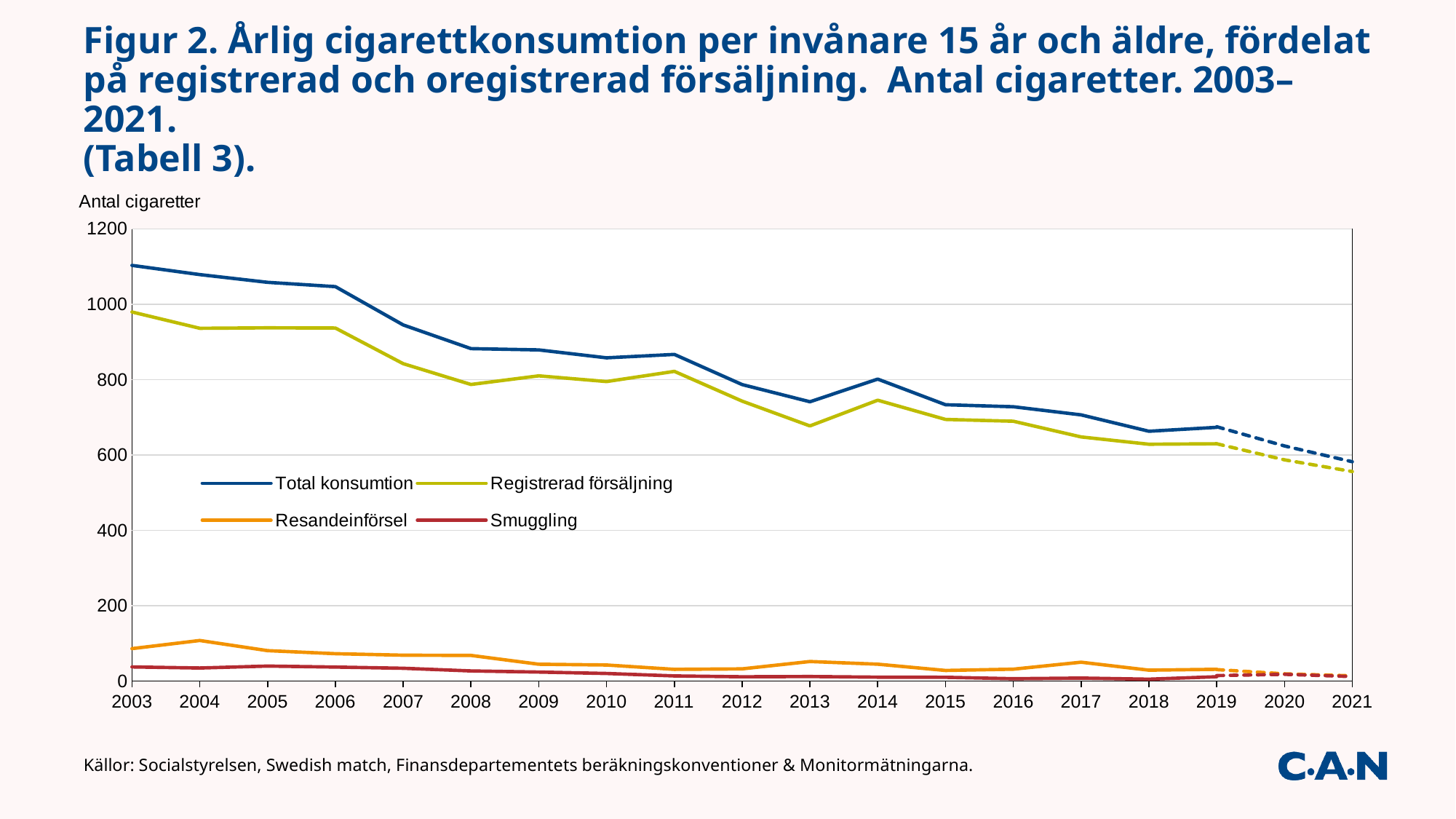
What is the label on the vertical axis of the chart? Antal cigaretter In which year is Resandeinförsel highest? 2004 In which year is Total konsumtion lowest? 2021 Is the value for Resandeinförsel in 2004 greater or less than 200? less Does the Total konsumtion line rise or fall from 2003 to 2021? fall Is the value for Registrerad försäljning in 2008 greater or less than 800? less What kind of chart is shown on the slide? line chart In which year is Total konsumtion highest? 2003 How many years are shown along the x axis? 19 Which is larger in 2013, Resandeinförsel or Smuggling? Resandeinförsel How many series does the legend list? 4 Is the value for Total konsumtion in 2003 greater or less than 1000? greater